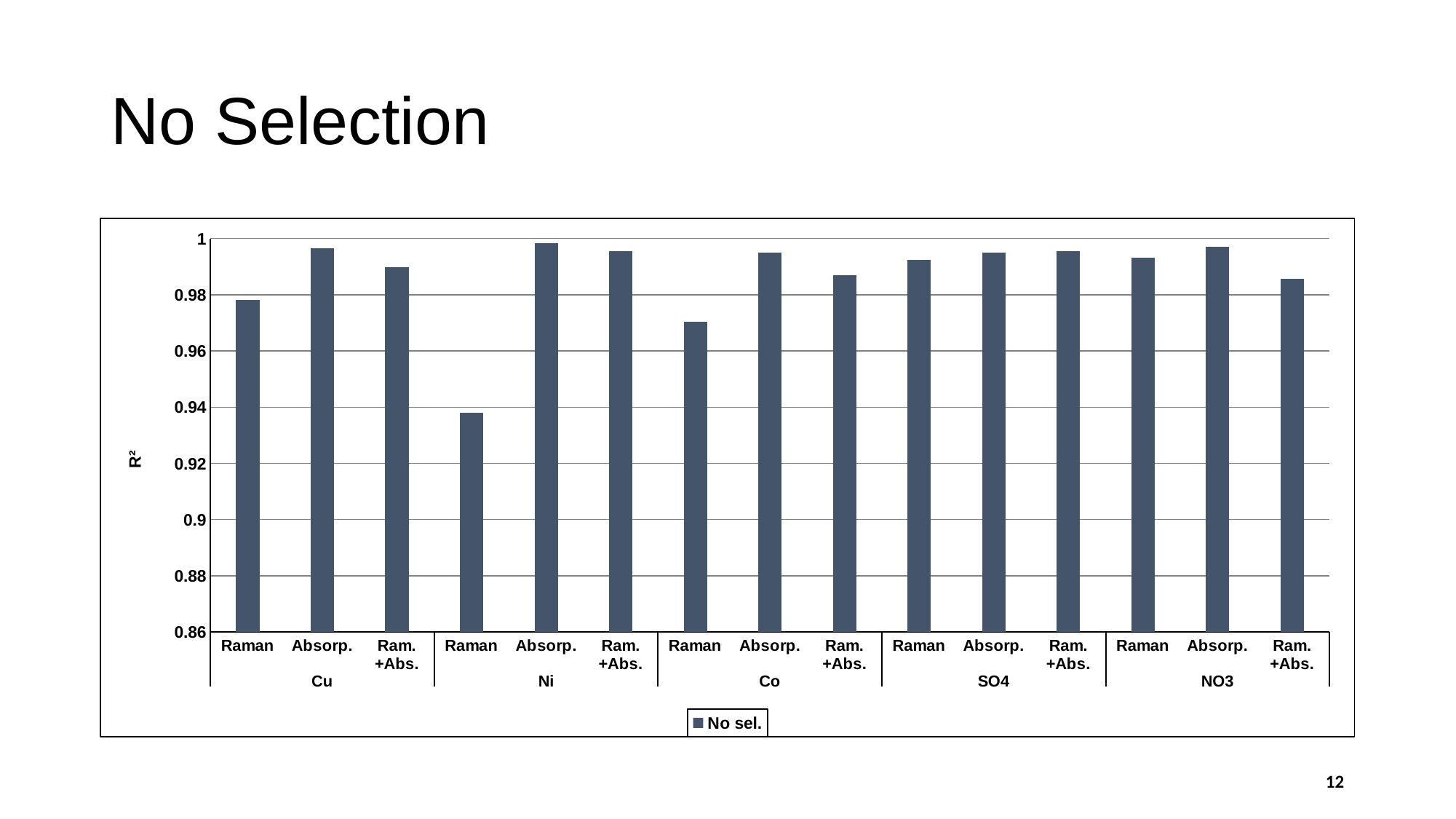
How many series does the legend list? 1 Is the R² value for Raman under Ni greater or less than 0.94? less What kind of chart is shown on the slide? bar chart What is the legend entry for the series in the chart? No sel. What is the label on the vertical axis of the chart? R² Is the R² value for Raman under Co greater or less than 0.96? greater How many bars are plotted in the chart? 15 Is the R² value for Raman under Cu greater or less than 0.98? less Which is larger, the R² value for Raman under Cu or for Absorp. under Cu? Absorp. under Cu Which bar has the lowest R² value in the chart? Raman for Ni Which is larger, the R² value for Raman under Ni or for Raman under Co? Raman under Co How many analyte groups (Cu, Ni, Co, SO4, NO3) are shown along the x axis? 5